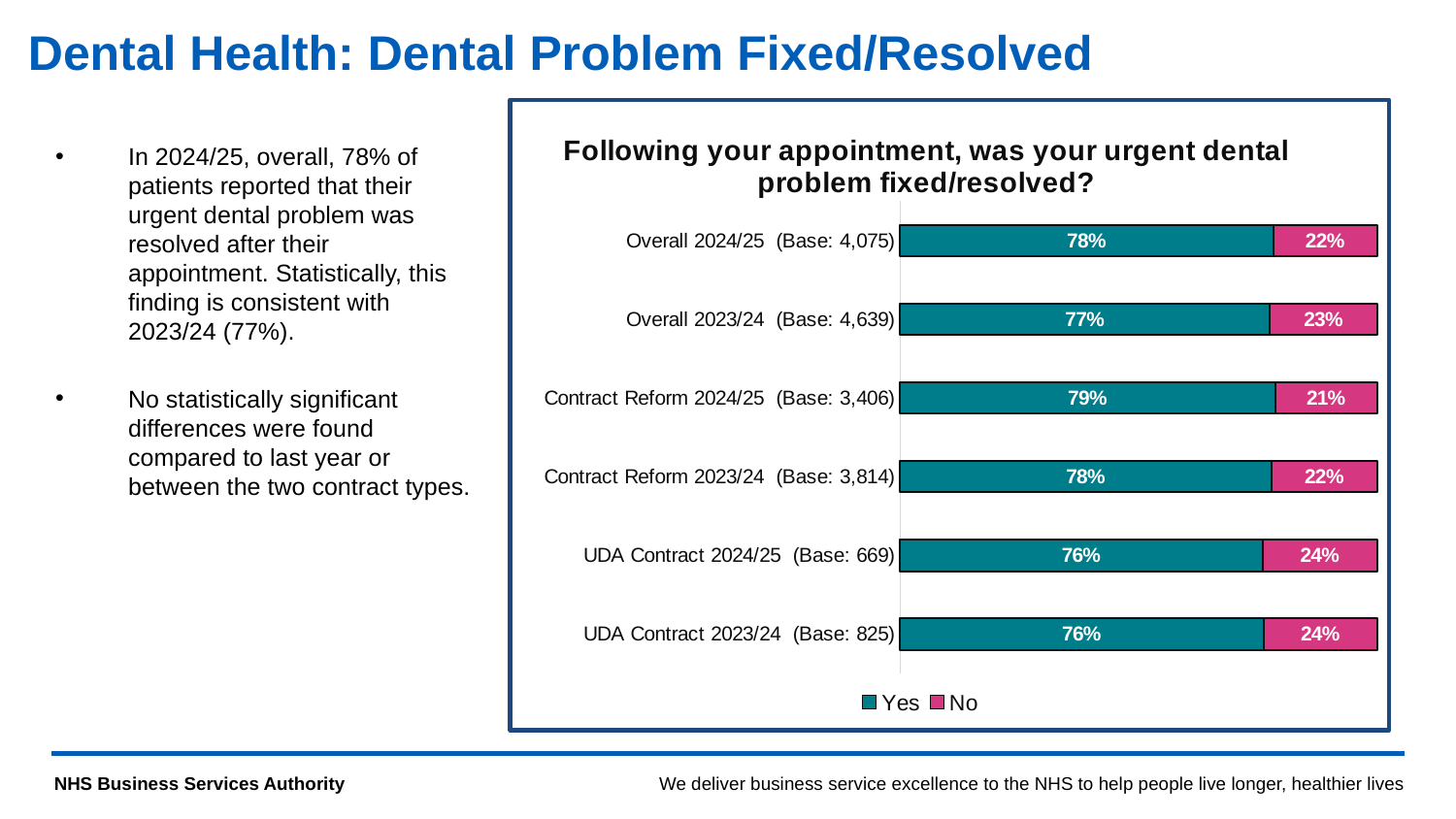
What is the total of the Yes and No values for UDA Contract 2024/25? 100% Which category has the lowest No percentage? Contract Reform 2024/25 How many series does the legend list? 2 What is the Yes value for Contract Reform 2024/25? 79% What is the difference between the Yes percentages for Overall 2024/25 and Overall 2023/24? 1% What percentage of UDA Contract 2023/24 respondents answered No? 24% What kind of chart is shown? Stacked bar chart Which category has the highest Yes percentage? Contract Reform 2024/25 What is the base size shown for Overall 2024/25? 4,075 How many categories are shown on the chart? 6 What percentage of Overall 2024/25 respondents answered Yes? 78% Which has a larger Yes percentage, Contract Reform 2023/24 or UDA Contract 2024/25? Contract Reform 2023/24